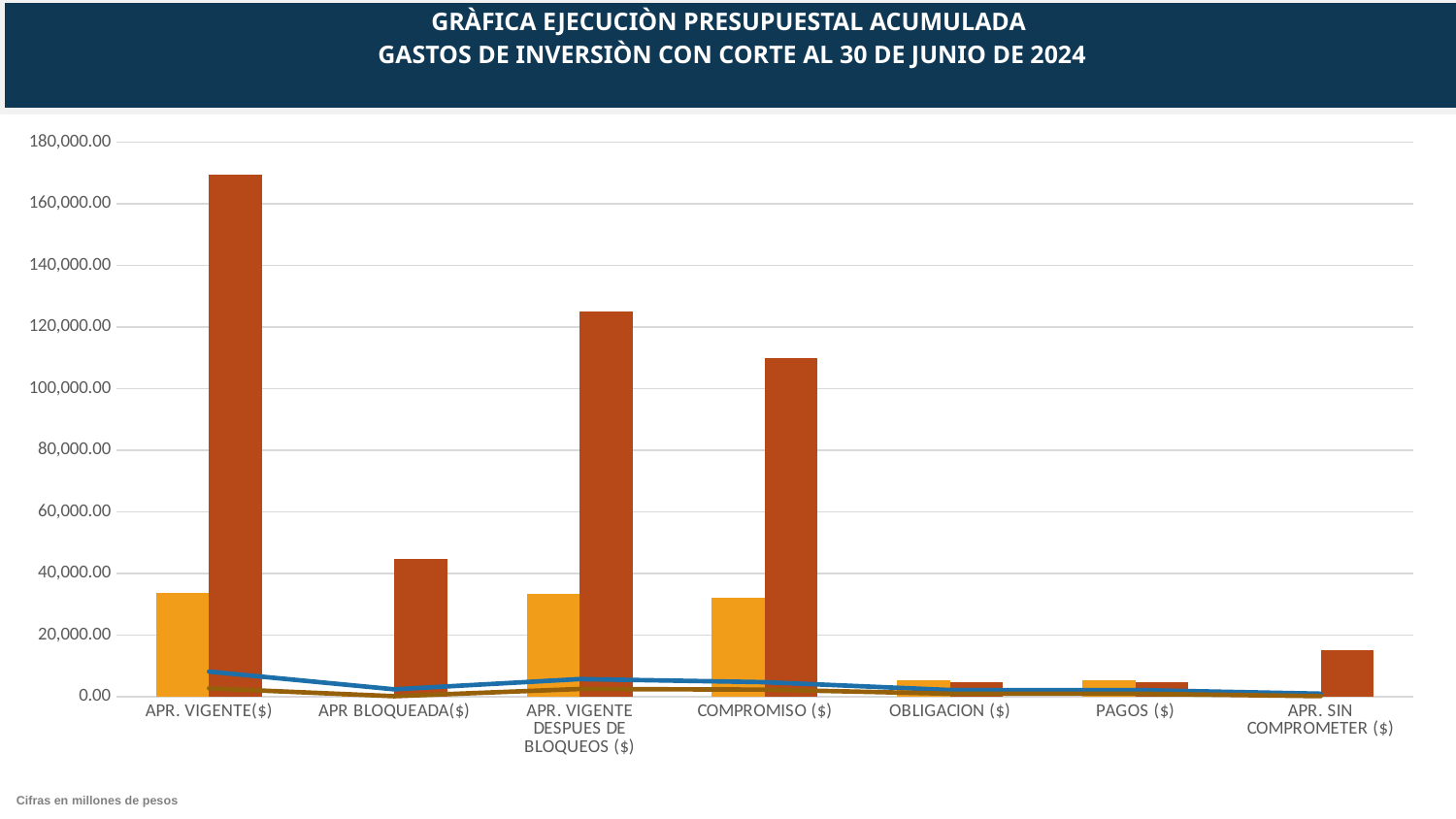
What is the highest value shown on the y axis of the chart? 180,000.00 Is the dark red bar for APR. SIN COMPROMETER ($) greater or less than 20,000.00? less Is the dark red bar for APR BLOQUEADA($) greater or less than 40,000.00? greater According to the note below the chart, in what units are the figures expressed? millones de pesos Is the dark red bar for APR. VIGENTE DESPUES DE BLOQUEOS ($) greater or less than 120,000.00? greater For APR. VIGENTE($), which bar is taller: the orange bar or the dark red bar? the dark red bar Which dark red bar is taller: COMPROMISO ($) or APR. VIGENTE DESPUES DE BLOQUEOS ($)? APR. VIGENTE DESPUES DE BLOQUEOS ($) How many categories are shown along the x axis of the chart? 7 Which category has the tallest dark red bar? APR. VIGENTE($)